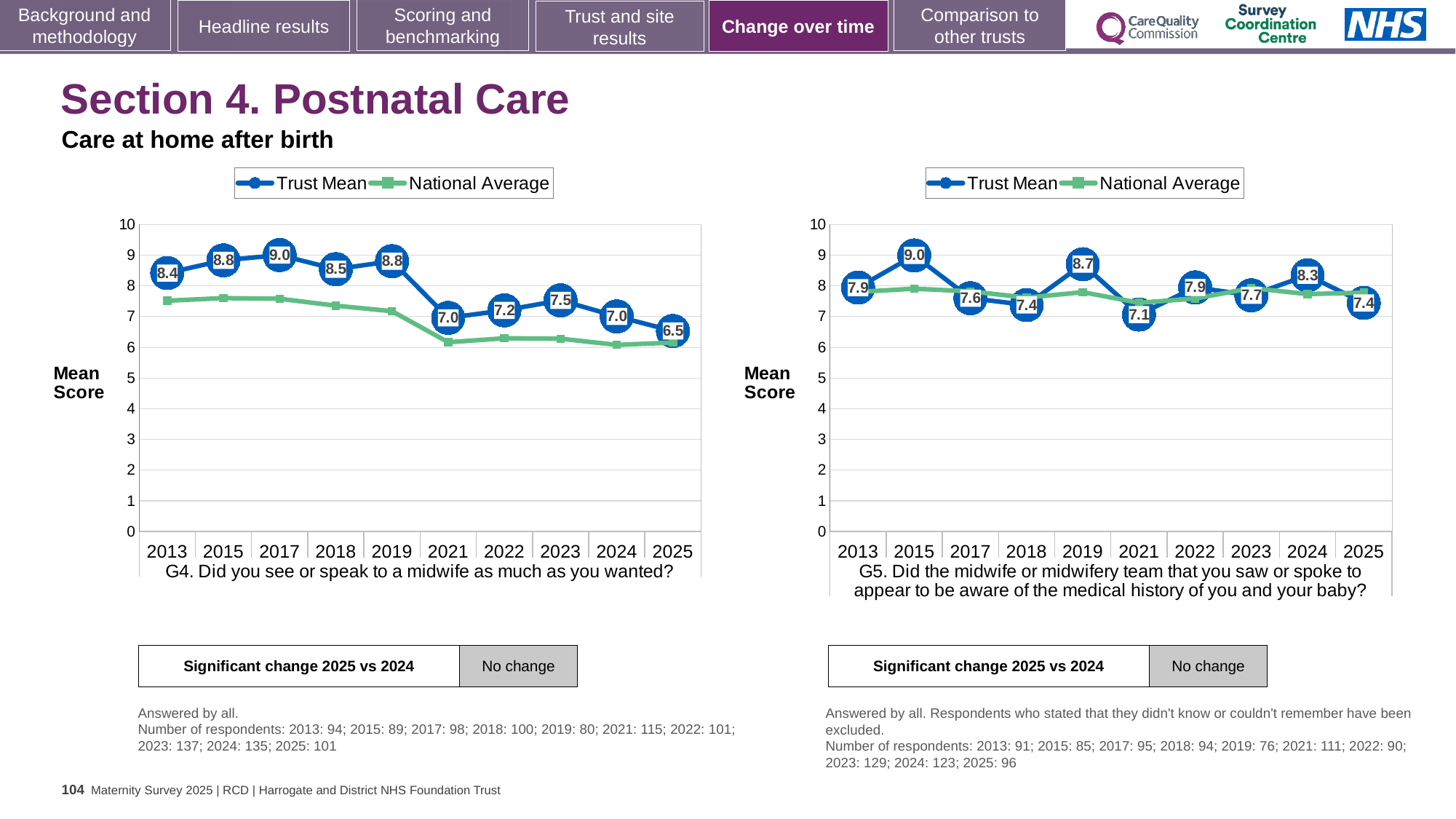
In the G5 chart (right), how many years are plotted on the x axis? 10 In the G5 chart (right), what is the Trust Mean for 2024? 8.3 How many series does the legend of the G4 chart (left) list? 2 In the G4 chart (left), what is the difference between the Trust Mean in 2019 and in 2021? 1.8 In the G4 chart (left), which year has the highest Trust Mean? 2017 In the G5 chart (right), which year has the highest Trust Mean? 2015 In the G4 chart (left), is the National Average for 2025 greater or less than 7? less What kind of chart is the G5 chart (right)? line chart In the G4 chart (left), which year has the lowest Trust Mean? 2025 In the G4 chart (left), what is the Trust Mean for 2025? 6.5 In the G5 chart (right), which is larger, the Trust Mean for 2019 or for 2023? 2019 In the G5 chart (right), which year has the lowest Trust Mean? 2021